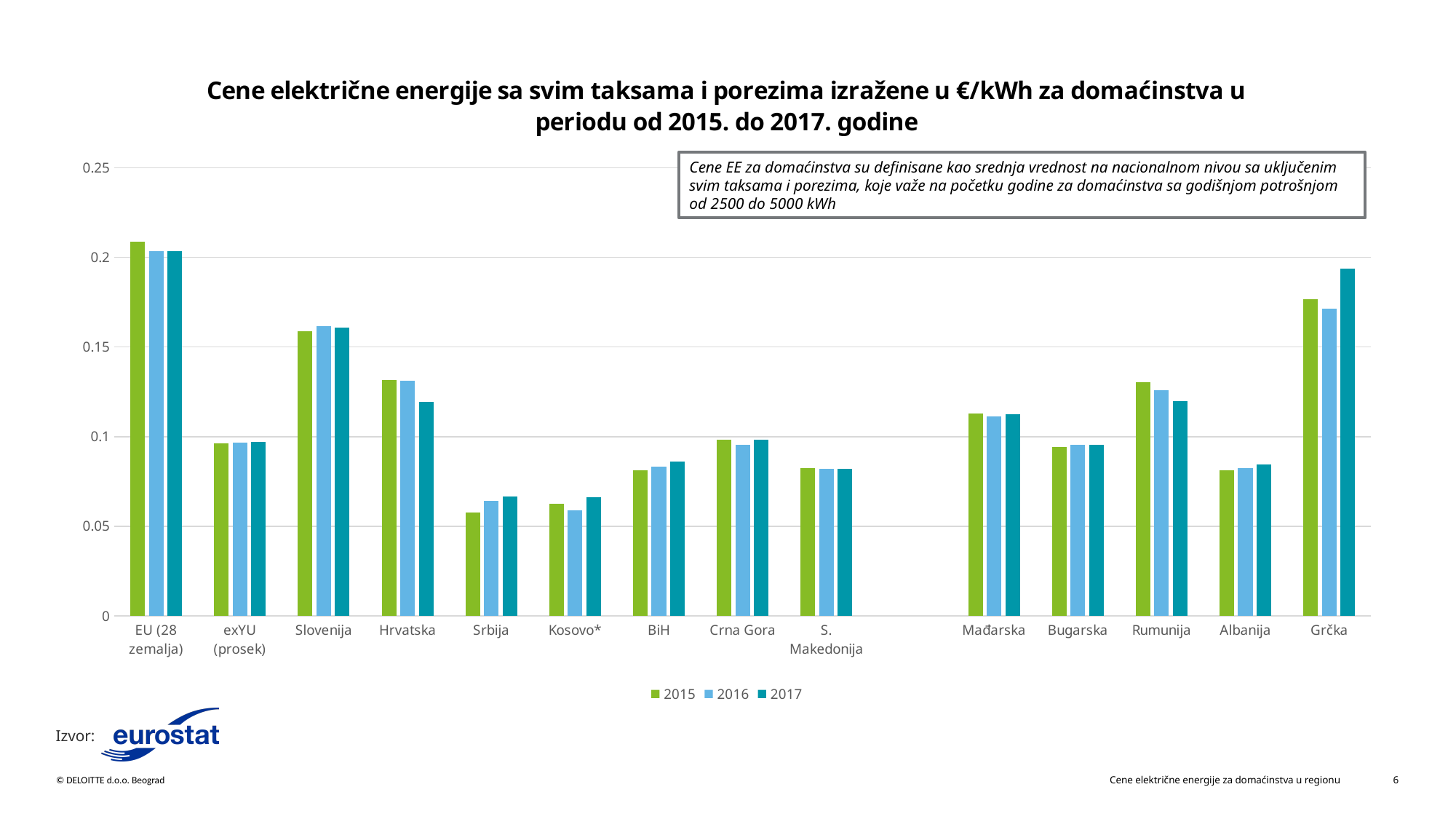
Is the 2015 value for Albanija greater or less than 0.1? less Is the 2016 value for Slovenija greater or less than 0.15? greater Do the values for Rumunija rise or fall from 2015 to 2017? fall Which is larger, the 2015 value for Slovenija or the 2015 value for Hrvatska? Slovenija What source is cited for the chart data? eurostat Is the 2017 value for Grčka greater or less than 0.2? less Which category has the lowest 2015 value? Srbija Which category has the highest 2015 value? EU (28 zemalja) How many series does the legend list? 3 What kind of chart is shown on the slide? bar chart How many countries or groups are labelled on the x axis? 14